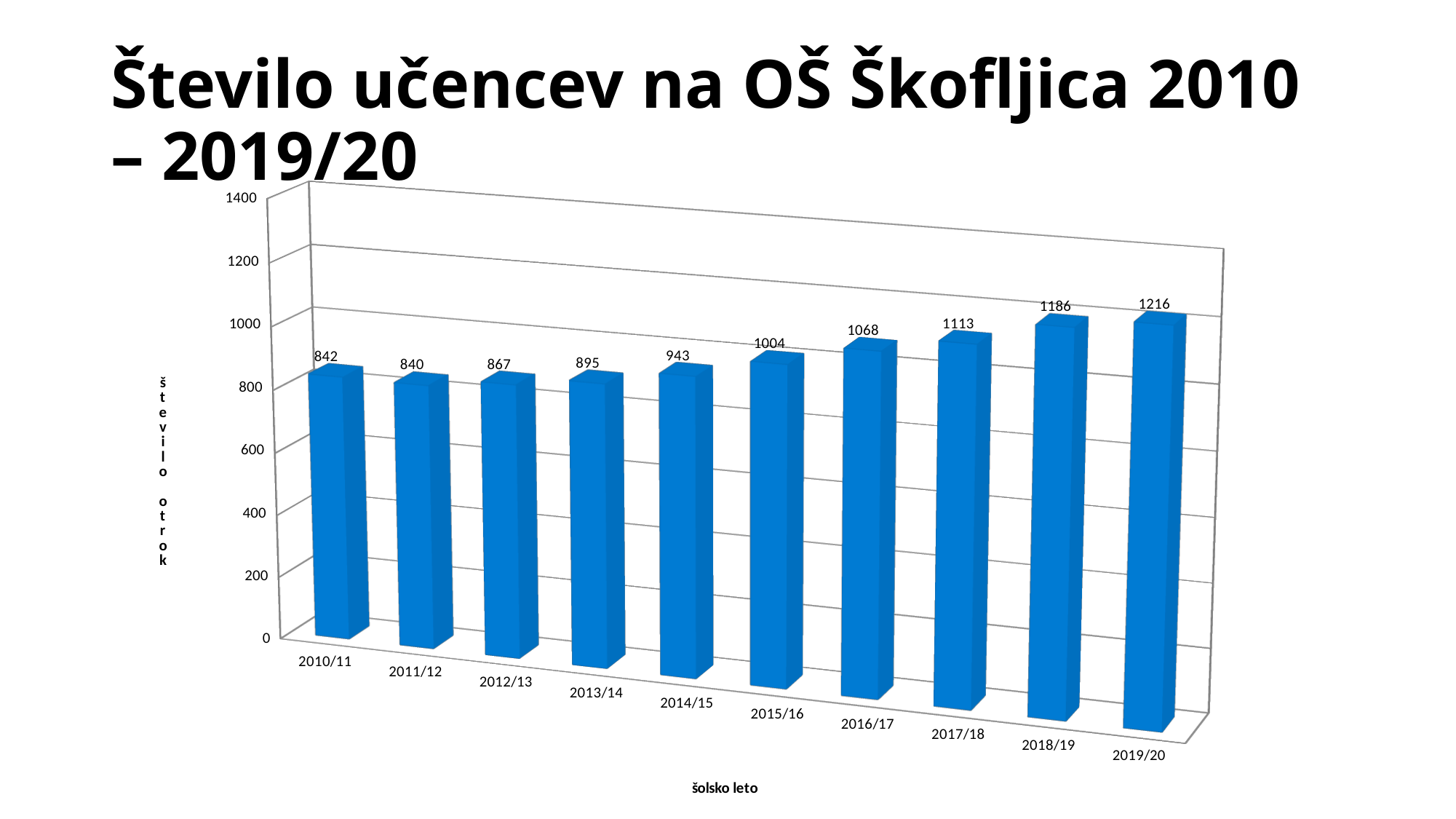
What kind of chart is shown on the slide? bar chart What is the number of pupils for 2019/20? 1216 What is the difference between the values for 2018/19 and 2017/18? 73 What is the difference between the values for 2019/20 and 2010/11? 374 What is the number of pupils for 2010/11? 842 What is the label of the x axis? šolsko leto Which school year has the highest number of pupils? 2019/20 Is the value for 2016/17 greater or less than 1000? greater What is the number of pupils for 2015/16? 1004 Which is larger, the value for 2013/14 or the value for 2014/15? 2014/15 How many school years are shown on the x axis? 10 Which school year has the lowest number of pupils? 2011/12